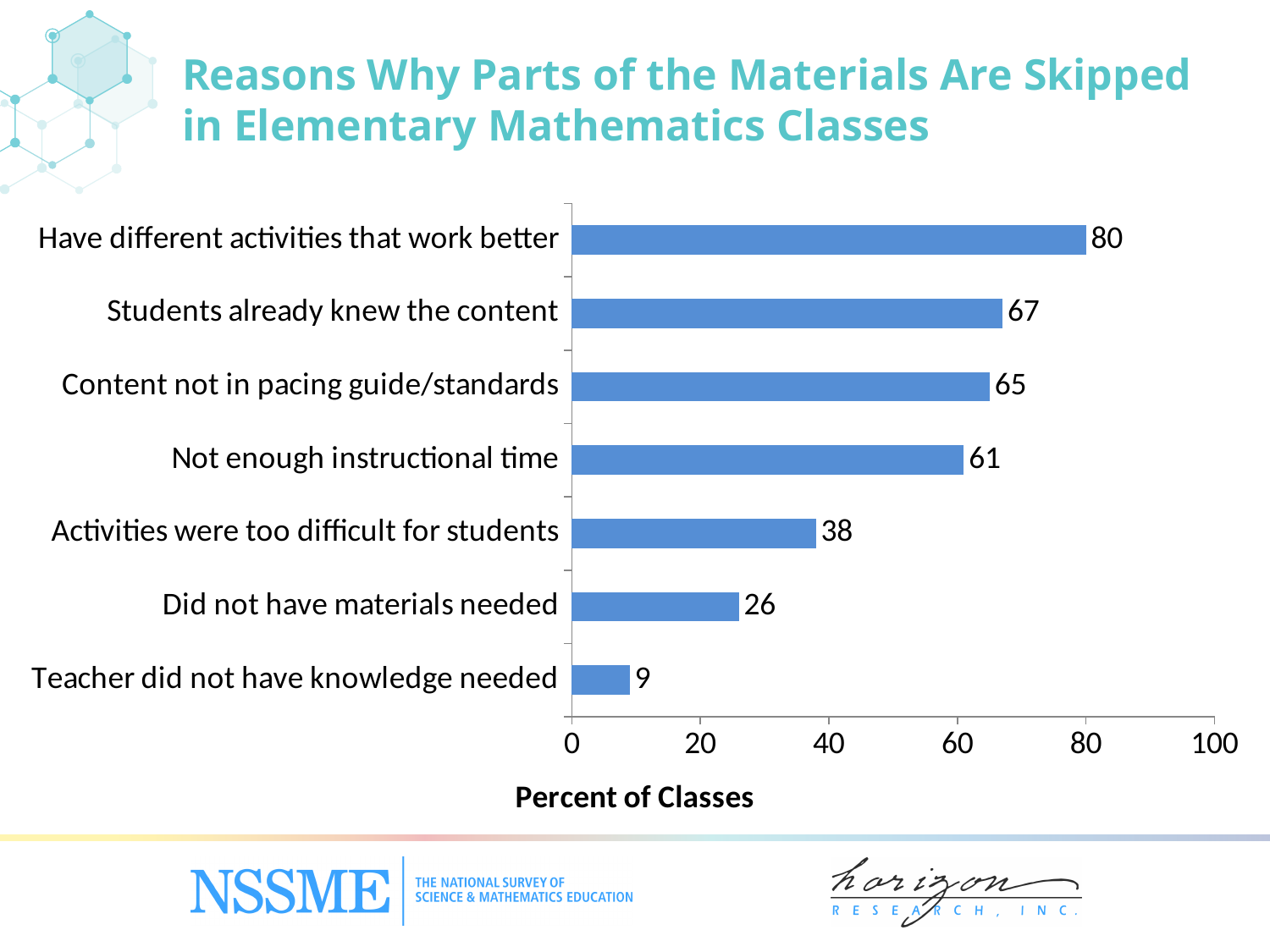
Which reason has the highest percent of classes? Have different activities that work better Which is larger: 'Content not in pacing guide/standards' or 'Not enough instructional time'? Content not in pacing guide/standards How many reasons are shown in the chart? 7 What is the value for 'Not enough instructional time'? 61 What percent of classes skipped parts of the materials because students already knew the content? 67 What is the difference between 'Have different activities that work better' and 'Activities were too difficult for students'? 42 What is the label of the horizontal axis? Percent of Classes What kind of chart is shown on the slide? Bar chart What is the title of the chart? Reasons Why Parts of the Materials Are Skipped in Elementary Mathematics Classes What is the value for 'Did not have materials needed'? 26 Which reason has the lowest percent of classes? Teacher did not have knowledge needed Is the value for 'Activities were too difficult for students' greater or less than 40? less